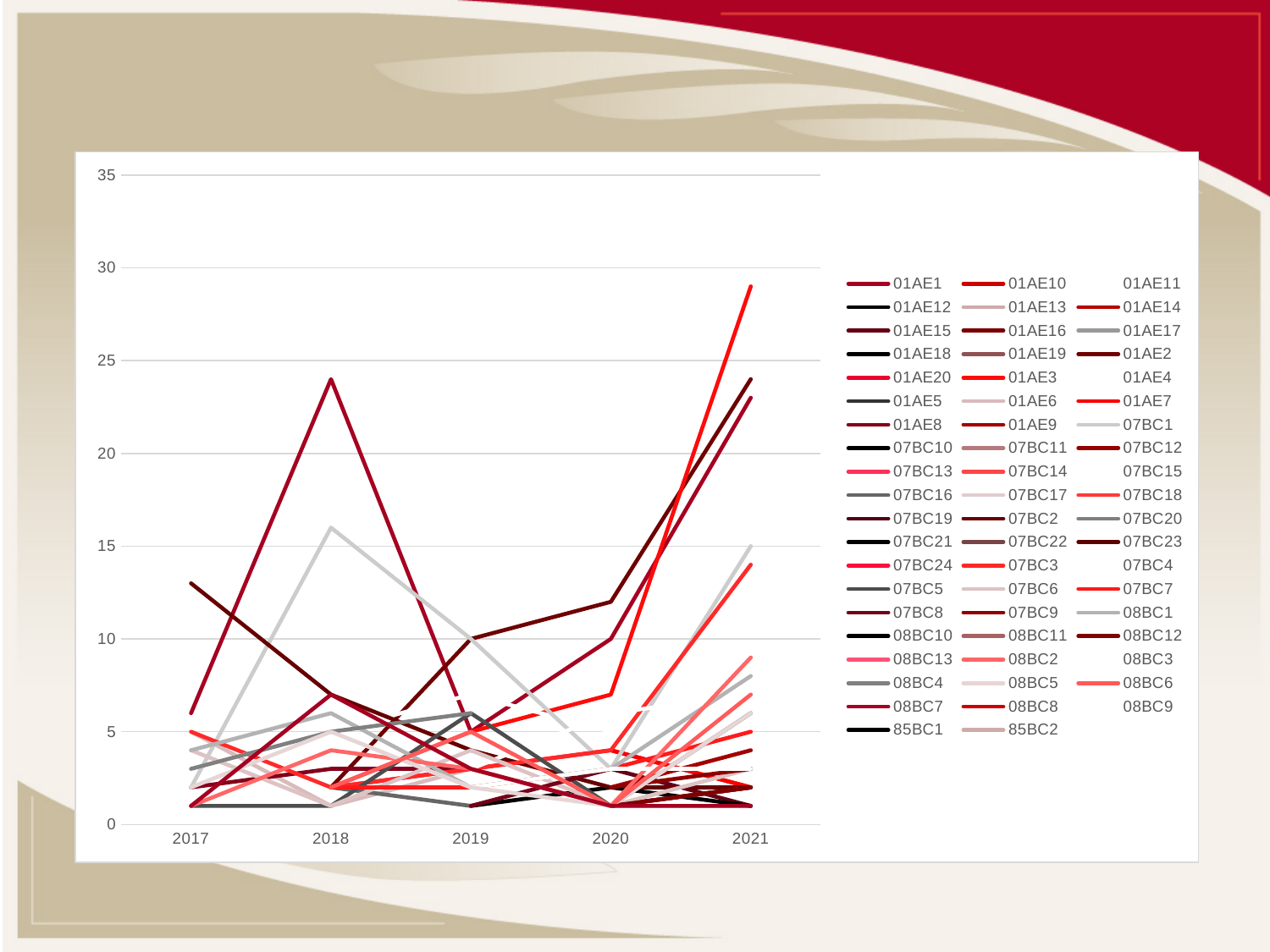
Is the highest value plotted in 2021 greater or less than 25? greater What is the last series name listed in the legend? 85BC2 What is the first year shown on the x axis? 2017 Is the highest value plotted in 2019 greater or less than 15? less How many series does the chart's legend list? 59 What kind of chart is shown on the slide? line chart Is the highest value plotted in 2017 greater or less than 15? less What is the first series name listed in the legend? 01AE1 What is the last year shown on the x axis? 2021 How many years are shown along the x axis of the chart? 5 What is the highest tick value shown on the y axis? 35